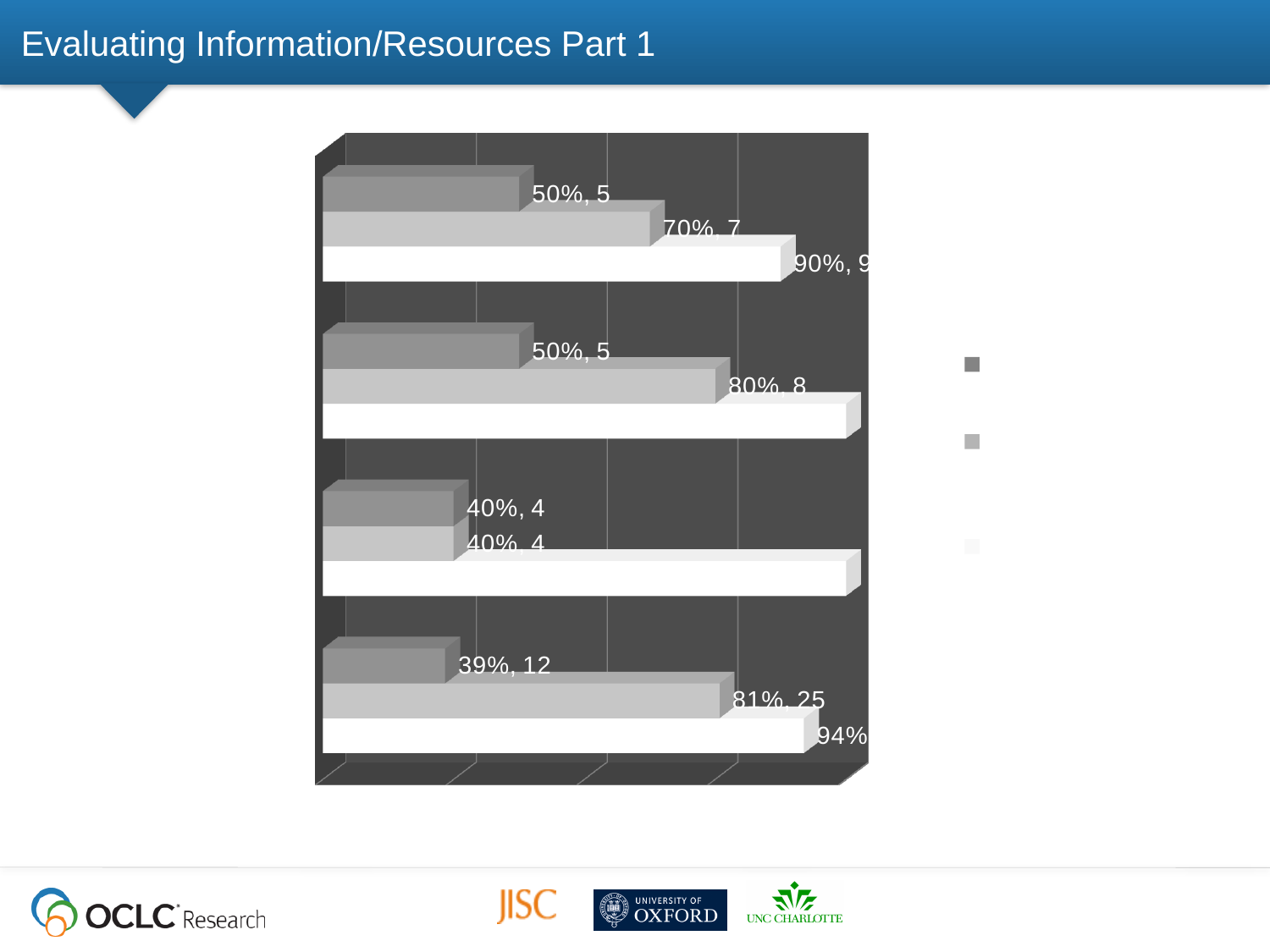
In the top group, which series has the highest value? the white bar What data label is shown on the dark grey bar in the bottom group? 39%, 12 What percentage is shown on the white bar in the bottom group? 94% How many groups of bars (categories) does the chart show? 4 What data label is shown on the white bar in the top group? 90%, 9 What is the difference in percentage between the light grey bar (81%) and the dark grey bar (39%) in the bottom group? 42 percentage points What data label is shown on the dark grey bar in the top group? 50%, 5 How many series does the legend list? 3 What data label is shown on the light grey bar in the second group from the top? 80%, 8 What kind of chart is shown on the slide? bar chart What is the difference in percentage between the white bar (90%) and the dark grey bar (50%) in the top group? 40 percentage points In the bottom group, which bar is larger: the light grey bar or the dark grey bar? the light grey bar